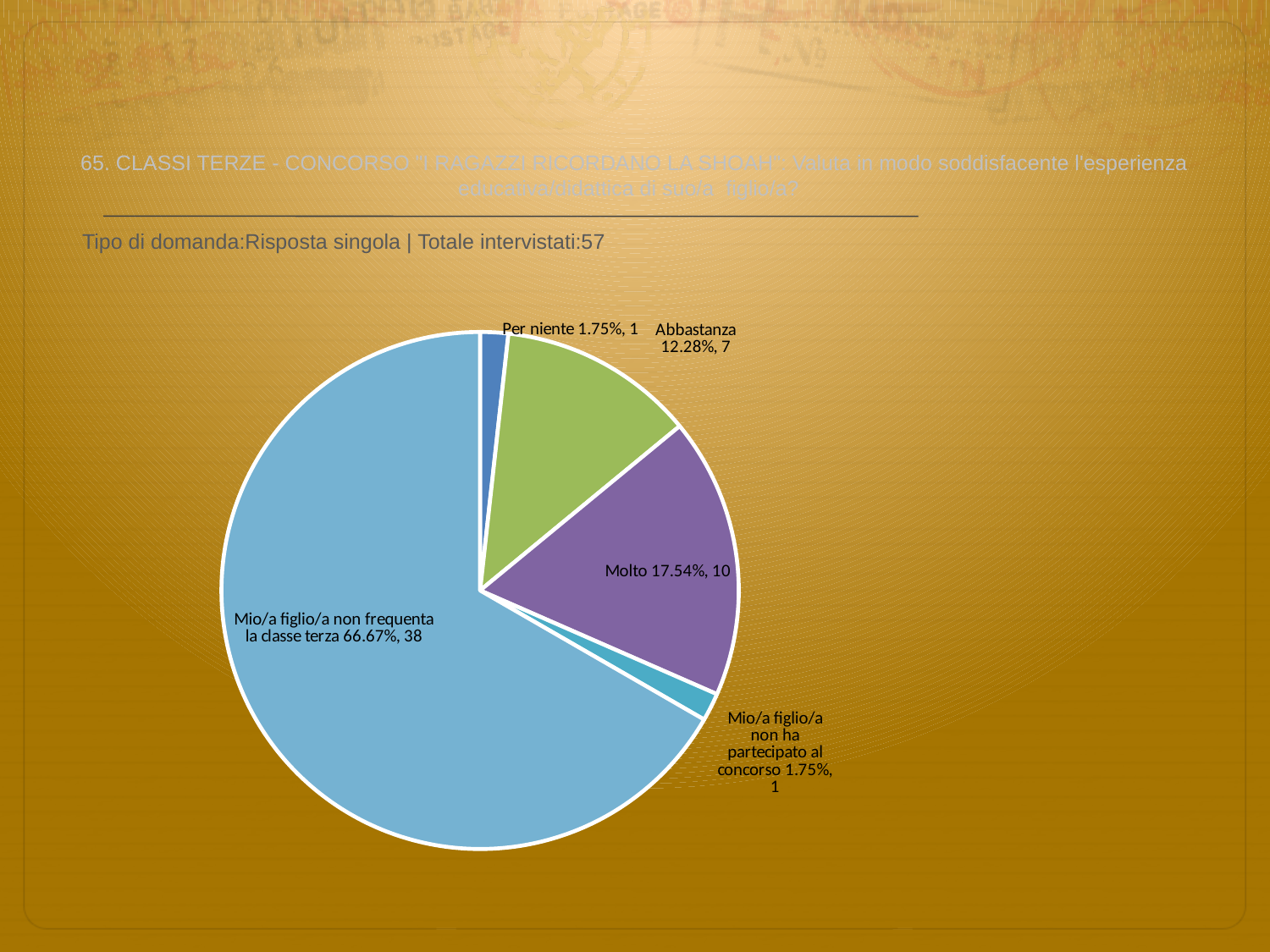
How many respondents answered "Abbastanza"? 7 What percentage share does the "Molto" slice have? 17.54% What percentage share does the "Mio/a figlio/a non ha partecipato al concorso" slice have? 1.75% What is the difference in respondent count between "Molto" and "Abbastanza"? 3 What percentage share does the "Mio/a figlio/a non frequenta la classe terza" slice have? 66.67% Which category has the largest slice of the pie? Mio/a figlio/a non frequenta la classe terza What kind of chart is shown on the slide? pie chart Which has more respondents, "Abbastanza" or "Molto"? Molto How many respondents answered "Molto"? 10 How many respondents answered "Per niente"? 1 How many slices does the pie chart have? 5 What is the total number of respondents (Totale intervistati) stated on the slide? 57